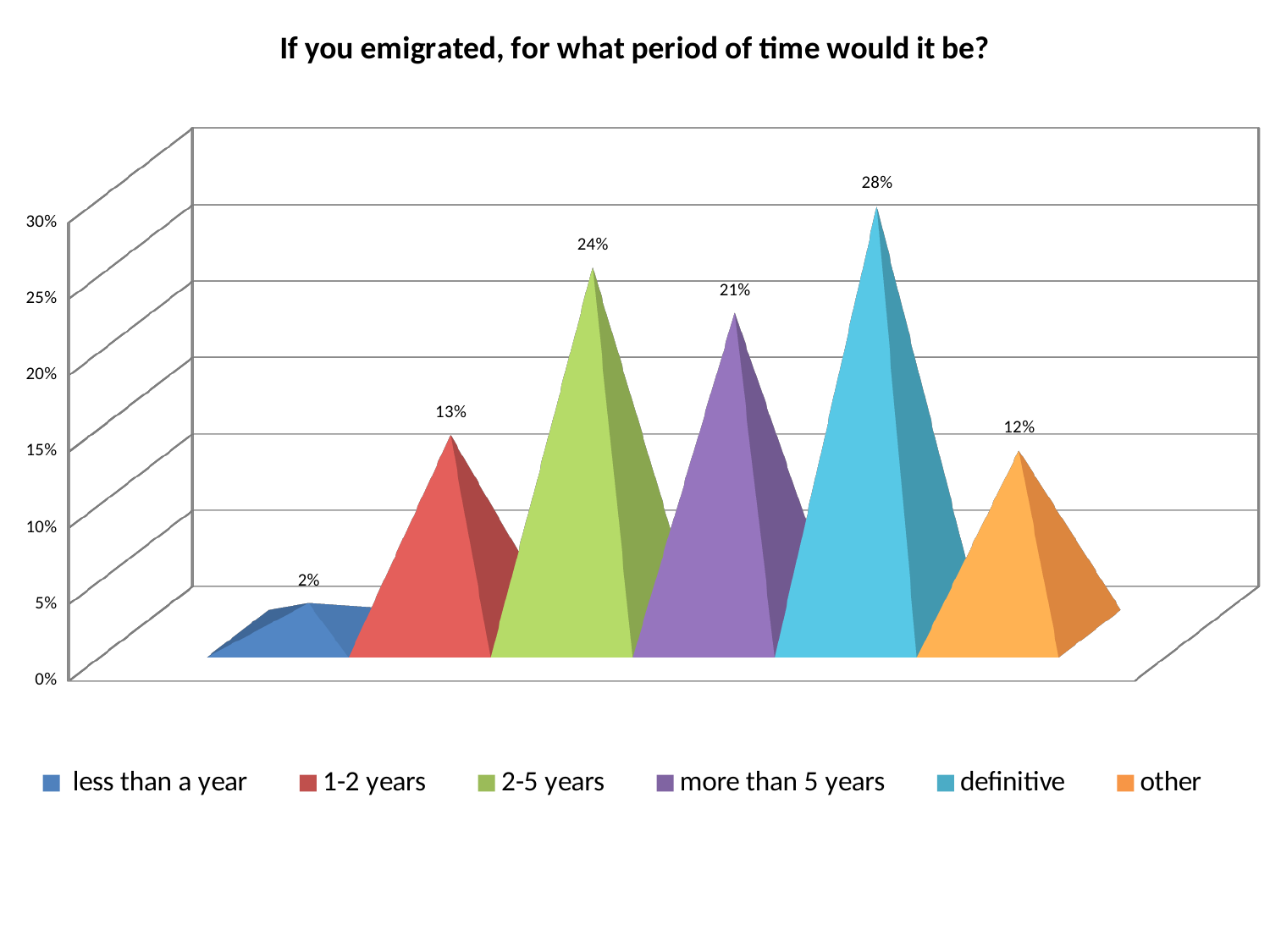
What is the value for "2-5 years"? 24% What colour is the "definitive" category in the legend? Light blue What is the difference between the values for "definitive" and "2-5 years"? 4% What is the difference between the values for "1-2 years" and "other"? 1% What is the value for "more than 5 years"? 21% How many categories does the chart show? 6 What is the title of the chart? If you emigrated, for what period of time would it be? What is the value for "less than a year"? 2% Which is larger, the value for "2-5 years" or the value for "more than 5 years"? 2-5 years Which category has the lowest value? less than a year Which category has the highest value? definitive What is the value for "definitive"? 28%